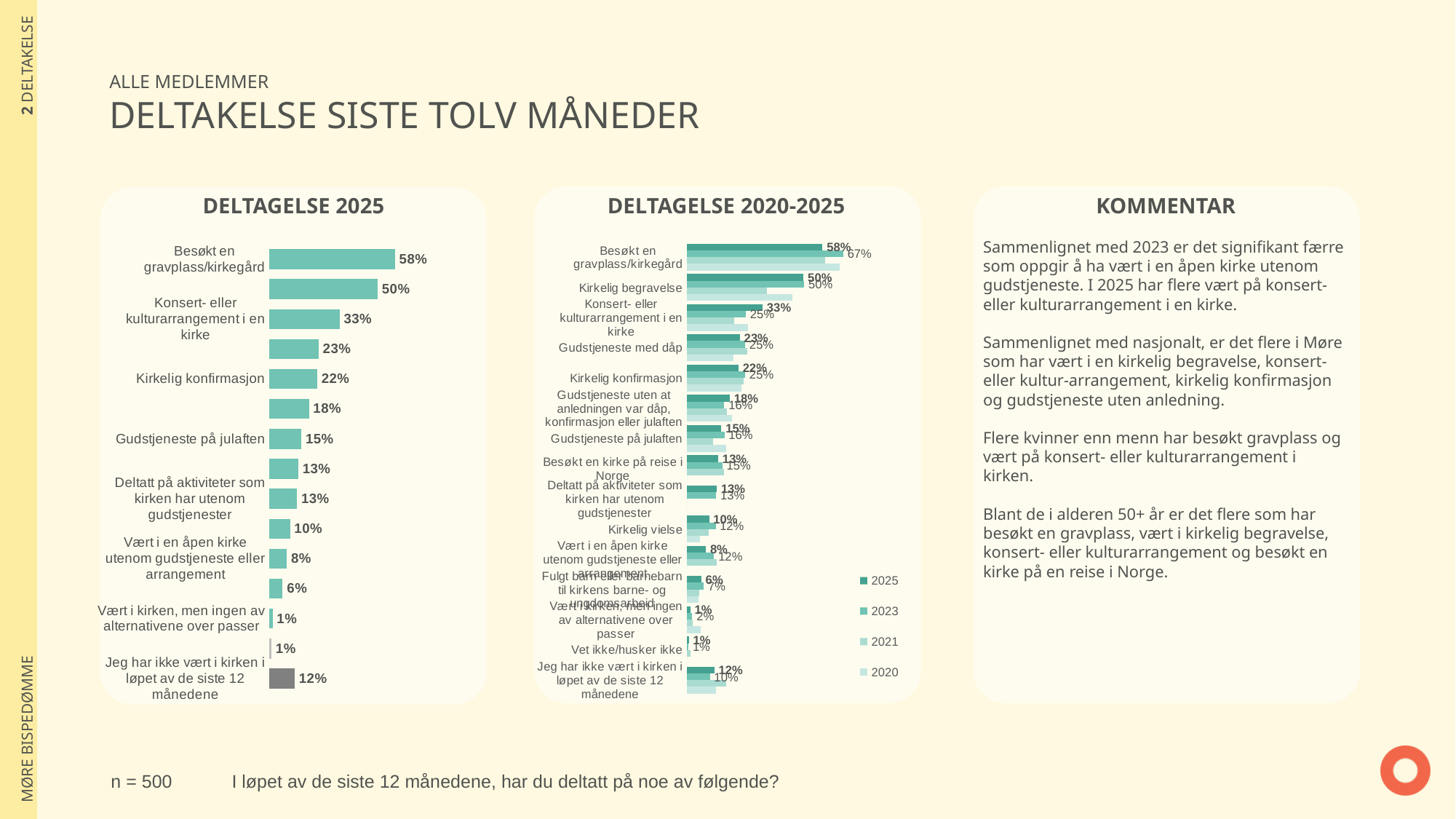
In the DELTAGELSE 2025 chart, what is the value for Besøkt en gravplass/kirkegård? 58% What are the legend entries in the DELTAGELSE 2020-2025 chart? 2025, 2023, 2021, 2020 What kind of chart is the DELTAGELSE 2025 chart? bar chart In the DELTAGELSE 2020-2025 chart, what is the 2025 value for Konsert- eller kulturarrangement i en kirke? 33% In the DELTAGELSE 2025 chart, which is larger: Gudstjeneste på julaften or Kirkelig konfirmasjon? Kirkelig konfirmasjon In the DELTAGELSE 2020-2025 chart, what is the 2025 value for Kirkelig vielse? 10% How many series does the legend of the DELTAGELSE 2020-2025 chart list? 4 In the DELTAGELSE 2020-2025 chart, what is the 2025 value for Kirkelig begravelse? 50% In the DELTAGELSE 2025 chart, which category has the highest value? Besøkt en gravplass/kirkegård How many categories are shown in the DELTAGELSE 2020-2025 chart? 15 In the DELTAGELSE 2020-2025 chart, what is the difference between the 2025 values for Besøkt en gravplass/kirkegård and Kirkelig begravelse? 8 percentage points In the DELTAGELSE 2025 chart, what is the value for Jeg har ikke vært i kirken i løpet av de siste 12 månedene? 12%